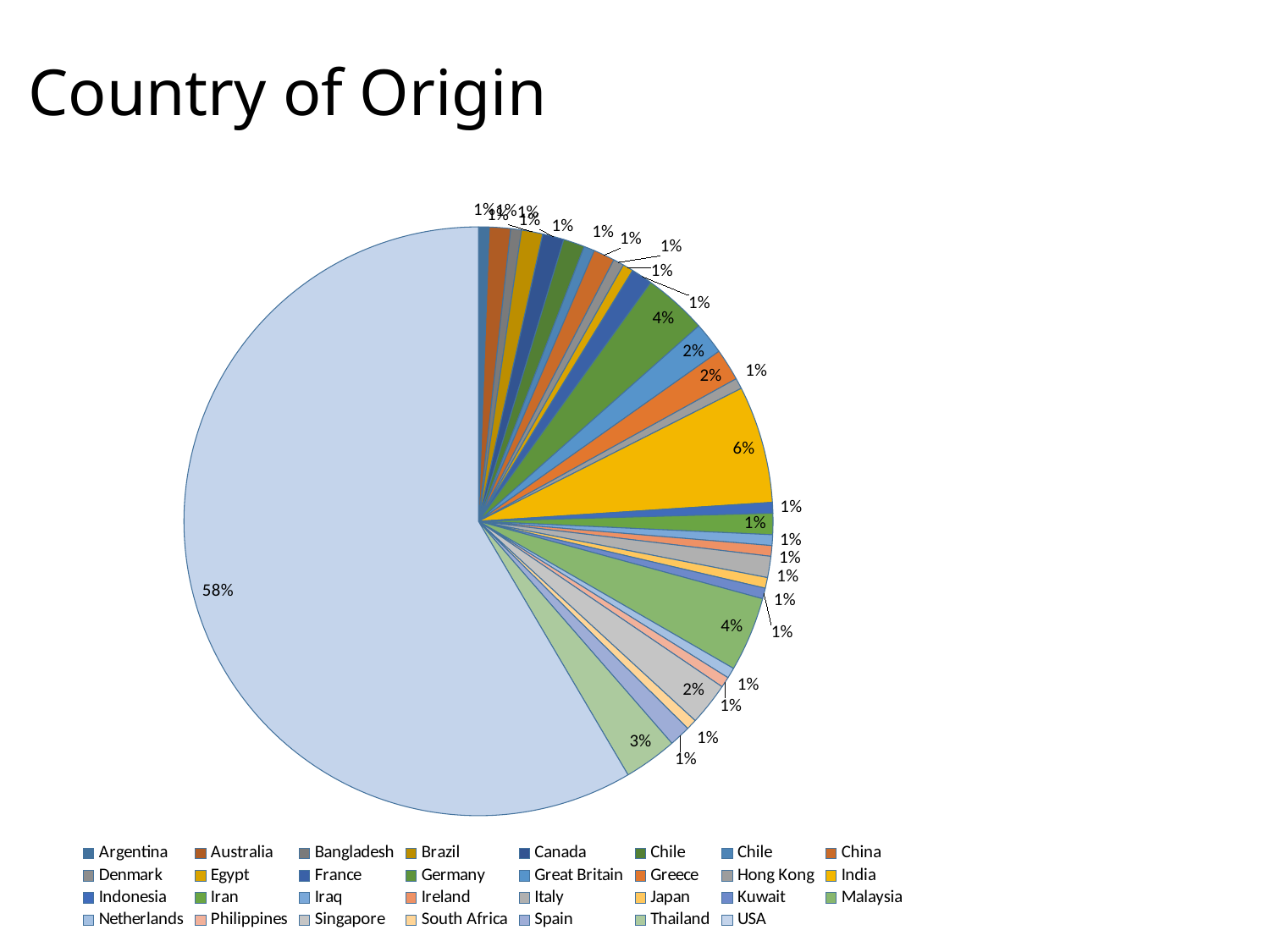
What is the value shown for Thailand? 3% How many countries are listed in the legend? 31 Which is larger, the share for USA or the share for India? USA What is the value shown for India? 6% What kind of chart is shown on the slide? pie chart What is the title of the chart? Country of Origin What is the difference between the USA share and the India share? 52% Which is larger, the share for Germany or the share for Thailand? Germany What is the value shown for Germany? 4% Which country name appears twice in the legend? Chile Which country has the largest share of the pie? USA What share of the pie does USA account for? 58%